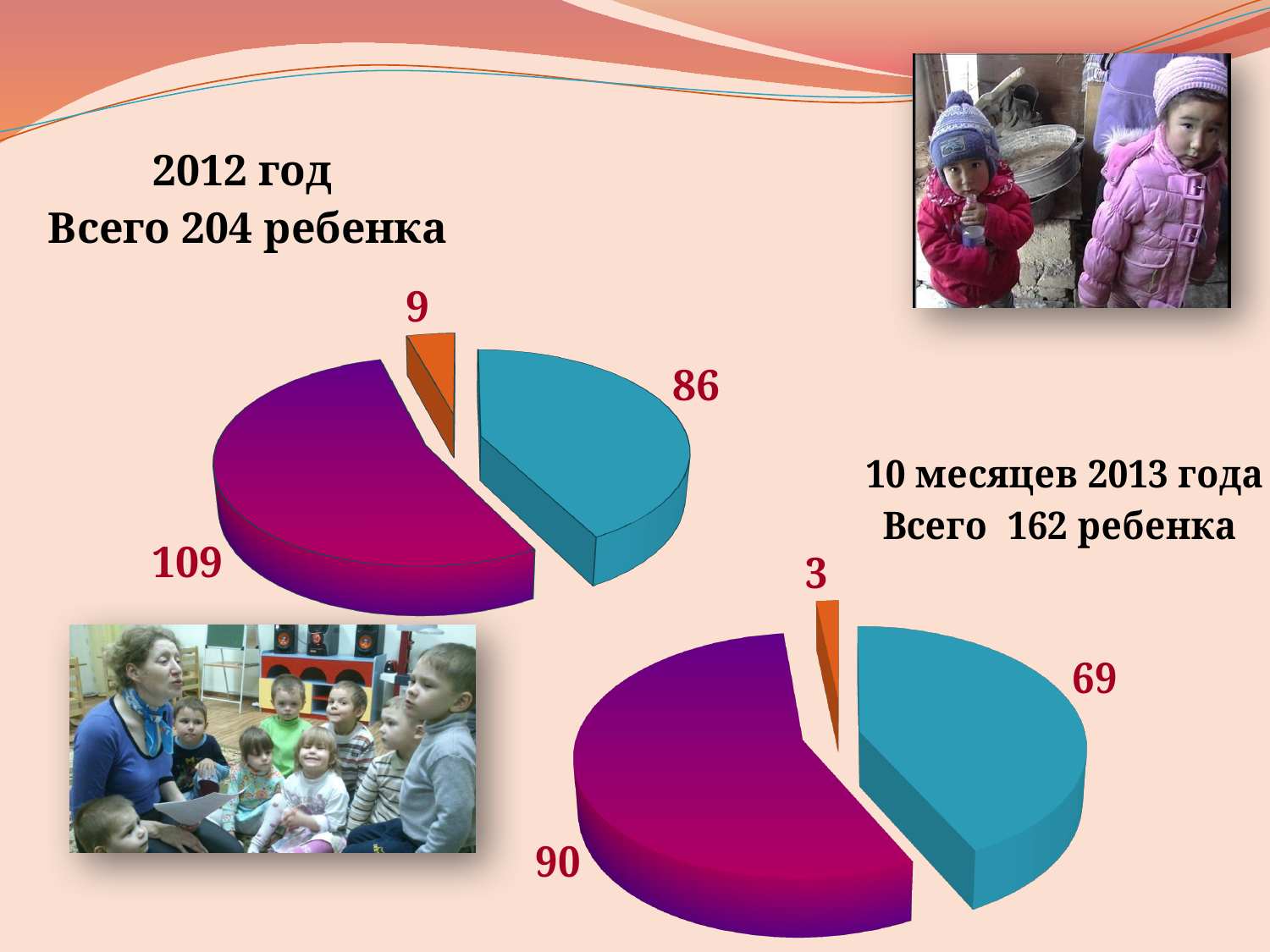
In the 2012 pie chart, what value is shown for the blue slice? 86 What type of chart is used for the 10 months of 2013 data? pie chart Which is larger: the blue slice in the 2012 chart or the blue slice in the 10 months of 2013 chart? the blue slice in the 2012 chart (86) In the 10 months of 2013 pie chart, what value is shown for the orange slice? 3 How many slices does the 2012 pie chart have? 3 In the 2012 pie chart, what value is shown for the purple slice? 109 In the 2012 pie chart, what is the difference between the purple slice and the blue slice? 23 In the 2012 pie chart, what value is shown for the orange slice? 9 In the 10 months of 2013 pie chart, what is the difference between the purple slice and the blue slice? 21 In the 10 months of 2013 pie chart, what value is shown for the blue slice? 69 In the 2012 pie chart, which slice has the smallest value? the orange slice (9) In the 10 months of 2013 pie chart, which slice has the largest value? the purple slice (90)